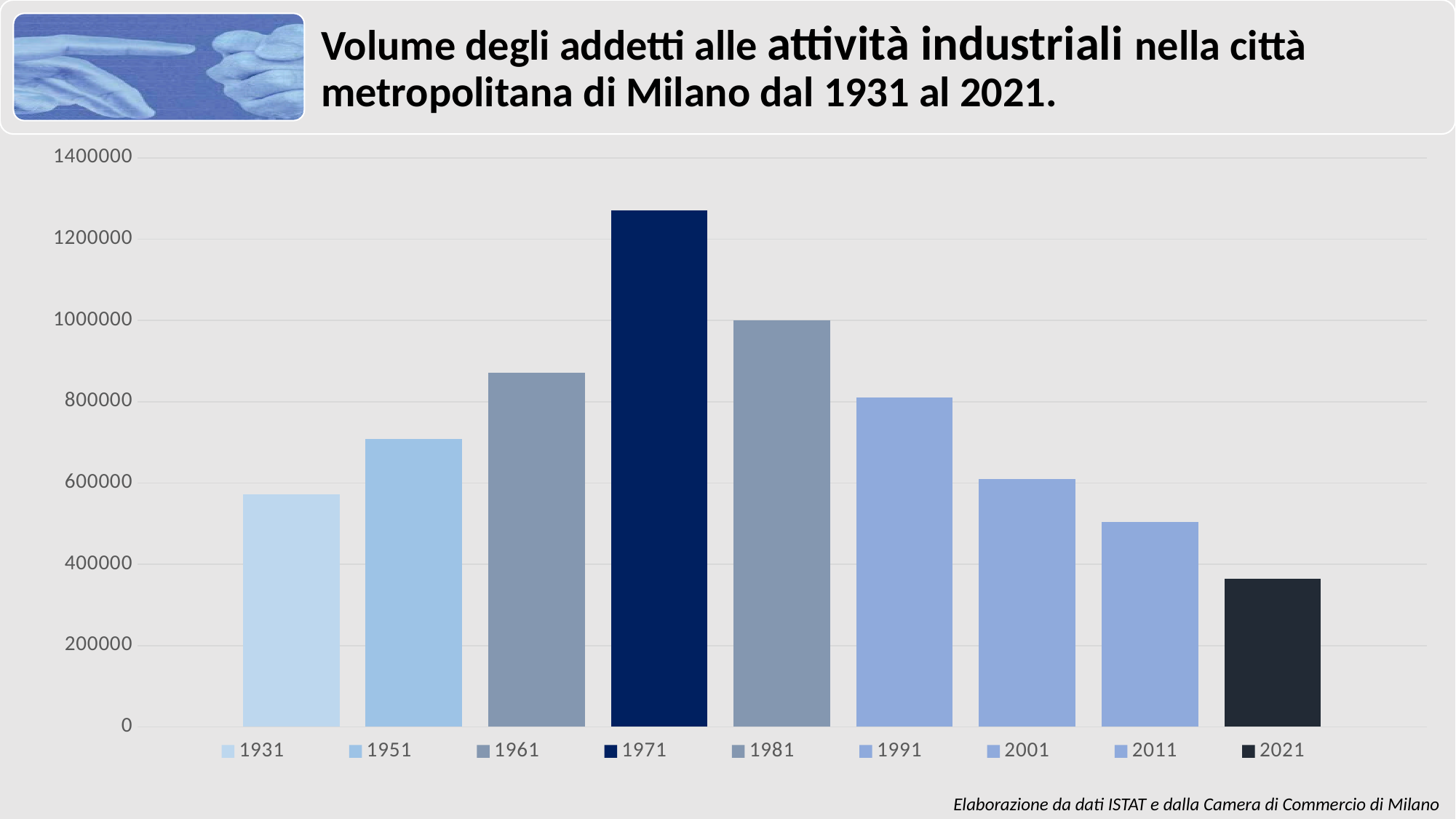
Is the value for 1961 greater or less than 800000? greater Which year has the lowest number of industrial workers in the chart? 2021 How many entries does the legend list? 9 Do the values rise or fall from 1971 to 2021? Fall Which is larger, the value for 2001 or the value for 2011? 2001 Is the value for 1971 greater or less than 1200000? greater Which year has the highest number of industrial workers in the chart? 1971 Is the value for 1931 greater or less than 600000? less What kind of chart is shown on the slide? Bar chart Which is larger, the value for 1951 or the value for 1991? 1991 How many years (bars) are shown in the chart? 9